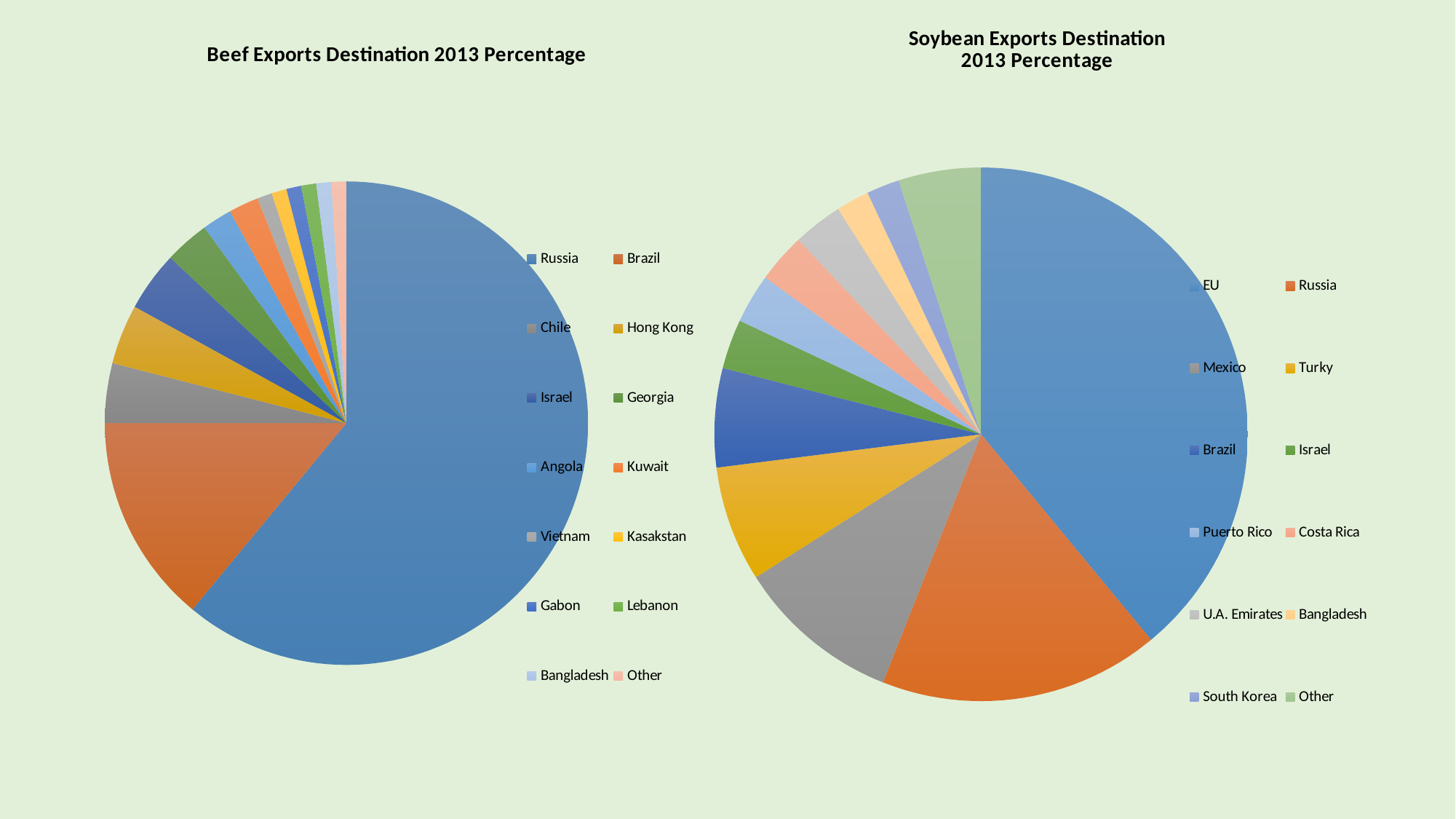
In the Beef Exports Destination 2013 Percentage chart, is Russia's slice more or less than half of the pie? More What is the title of the pie chart on the right side of the slide? Soybean Exports Destination 2013 Percentage In the Soybean Exports Destination 2013 Percentage chart, which destination has the largest slice? EU What kind of chart is the Soybean Exports Destination 2013 Percentage chart? Pie chart In the Soybean Exports Destination 2013 Percentage chart, which legend entry is listed last? Other In the Soybean Exports Destination 2013 Percentage chart, which slice is larger, Russia or Mexico? Russia In the Beef Exports Destination 2013 Percentage chart, which slice is larger, Brazil or Chile? Brazil In the Beef Exports Destination 2013 Percentage chart, which destination has the largest slice? Russia How many destinations are listed in the legend of the Soybean Exports Destination 2013 Percentage chart? 12 What kind of chart is the Beef Exports Destination 2013 Percentage chart? Pie chart In the Soybean Exports Destination 2013 Percentage chart, which slice is larger, Brazil or Israel? Brazil How many destinations are listed in the legend of the Beef Exports Destination 2013 Percentage chart? 14